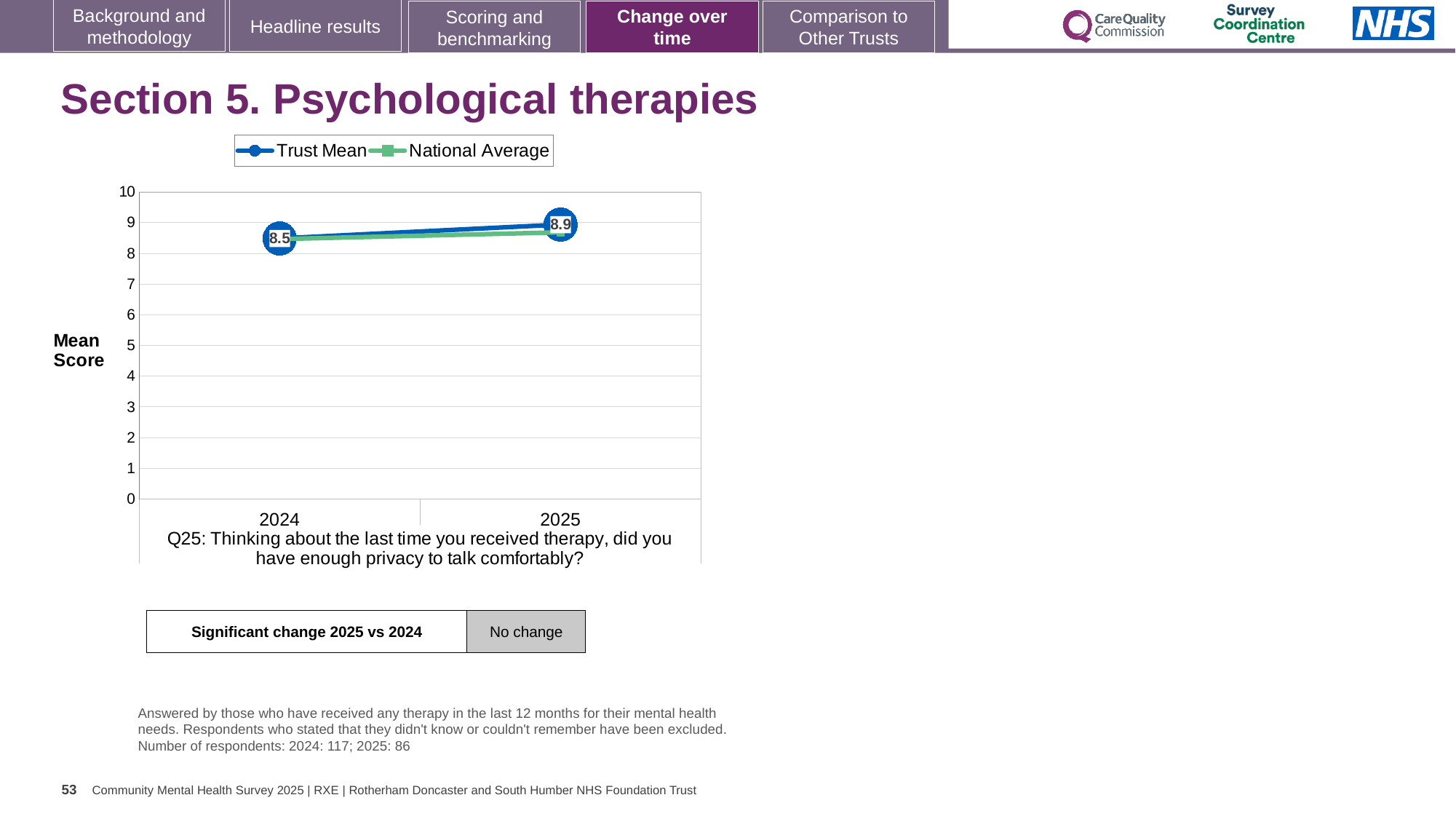
Does the Trust Mean rise or fall from 2024 to 2025? rise By how much did the Trust Mean change from 2024 to 2025? 0.4 What kind of chart is shown on the slide? line chart What are the two series named in the chart legend? Trust Mean and National Average Which year has the higher Trust Mean, 2024 or 2025? 2025 What is the Trust Mean value for 2025? 8.9 Is the National Average value for 2025 greater or less than 8? greater How many series does the chart legend list? 2 How many years are shown on the x axis of the chart? 2 In which year is the Trust Mean highest? 2025 What is the Trust Mean value for 2024? 8.5 Is the National Average value for 2024 greater or less than 7? greater